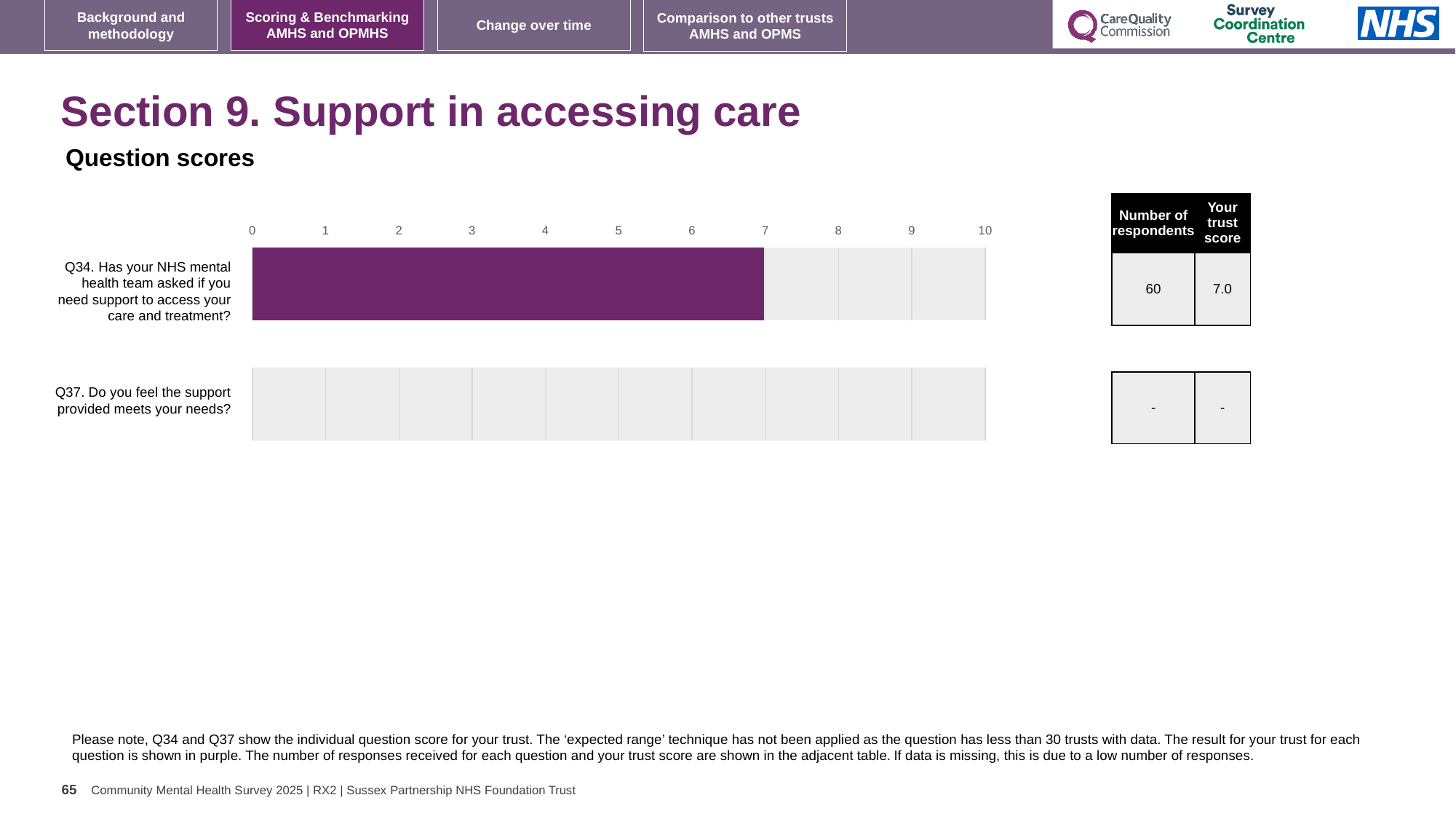
Is the value for Q34 greater or less than 8? less Is the value for Q34 greater or less than 5? greater Which question on the chart has a plotted bar? Q34 What is the trust score for Q34 on the question scores chart? 7.0 What is shown in the table for the number of respondents and trust score for Q37? - How many respondents answered Q34 according to the table next to the chart? 60 What colour is the bar for Q34 on the question scores chart? purple What is the maximum value shown on the x axis of the question scores chart? 10 How many questions are listed on the question scores chart? 2 What kind of chart is used to show the question scores? bar chart